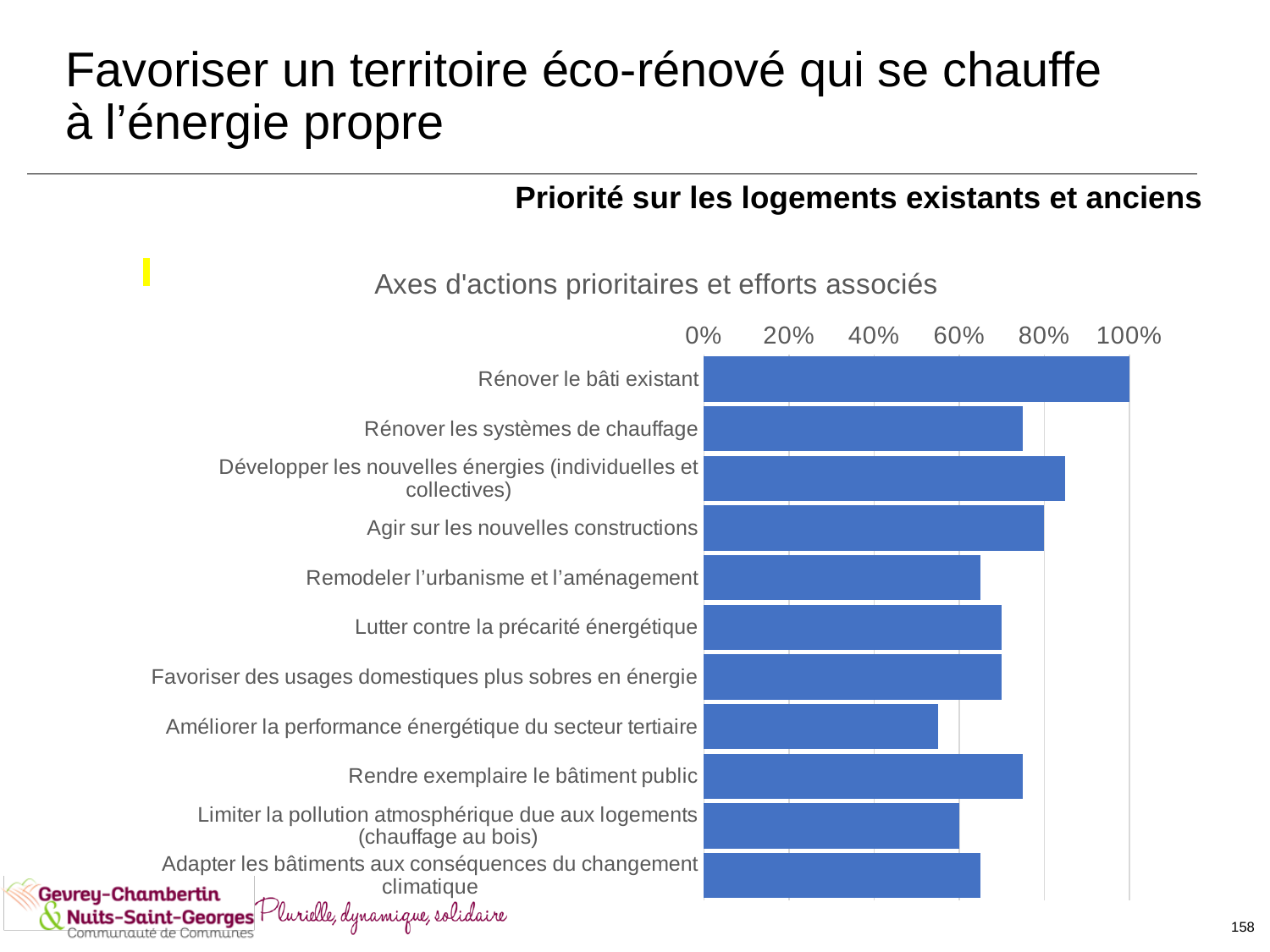
Is the value for 'Améliorer la performance énergétique du secteur tertiaire' greater or less than 60%? less Which is larger: the value for 'Rénover le bâti existant' or for 'Remodeler l'urbanisme et l'aménagement'? Rénover le bâti existant How many action categories are plotted in the chart? 11 Which is larger: the value for 'Développer les nouvelles énergies (individuelles et collectives)' or for 'Limiter la pollution atmosphérique due aux logements (chauffage au bois)'? Développer les nouvelles énergies (individuelles et collectives) Is the value for 'Agir sur les nouvelles constructions' greater or less than 60%? greater What is the value for 'Rénover le bâti existant'? 100% Which category has the lowest value in the chart? Améliorer la performance énergétique du secteur tertiaire Is the value for 'Limiter la pollution atmosphérique due aux logements (chauffage au bois)' greater or less than 80%? less What kind of chart is shown on the slide? bar chart Which category has the highest value in the chart? Rénover le bâti existant What is the title of the chart? Axes d'actions prioritaires et efforts associés